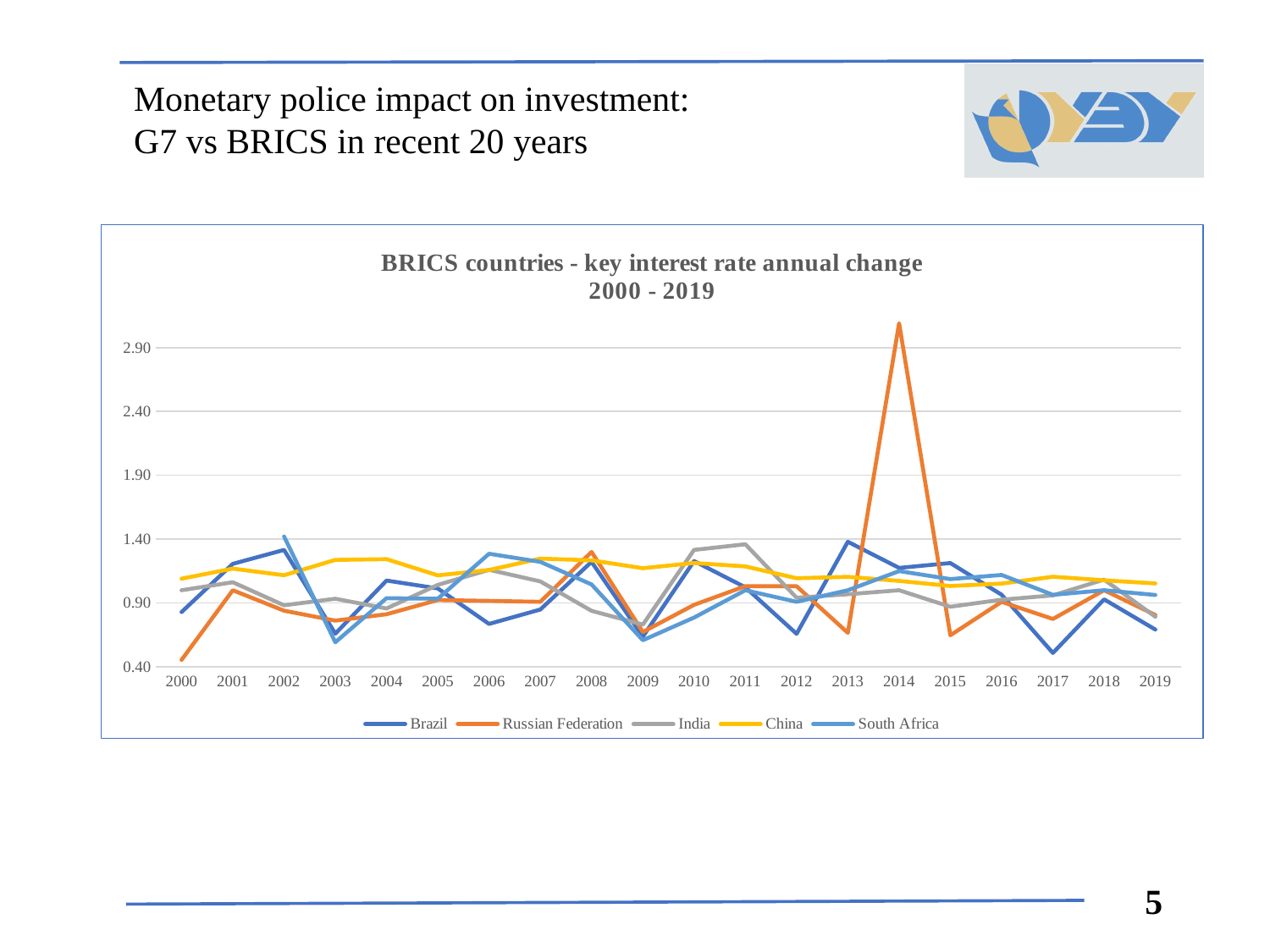
Is the value for Russian Federation in 2000 greater or less than 0.90? less What is the title of the chart? BRICS countries - key interest rate annual change 2000 - 2019 Is the value for Brazil in 2017 greater or less than 0.90? less What kind of chart is shown on the slide? line chart Is the value for China in 2014 greater or less than 0.90? greater In which year does the Russian Federation series reach its peak? 2014 Which series has the lowest value in 2000? Russian Federation In 2014, which is larger: the value for Russian Federation or the value for Brazil? Russian Federation How many years are plotted along the x axis? 20 Which series reaches the highest value anywhere on the chart? Russian Federation How many series does the legend list? 5